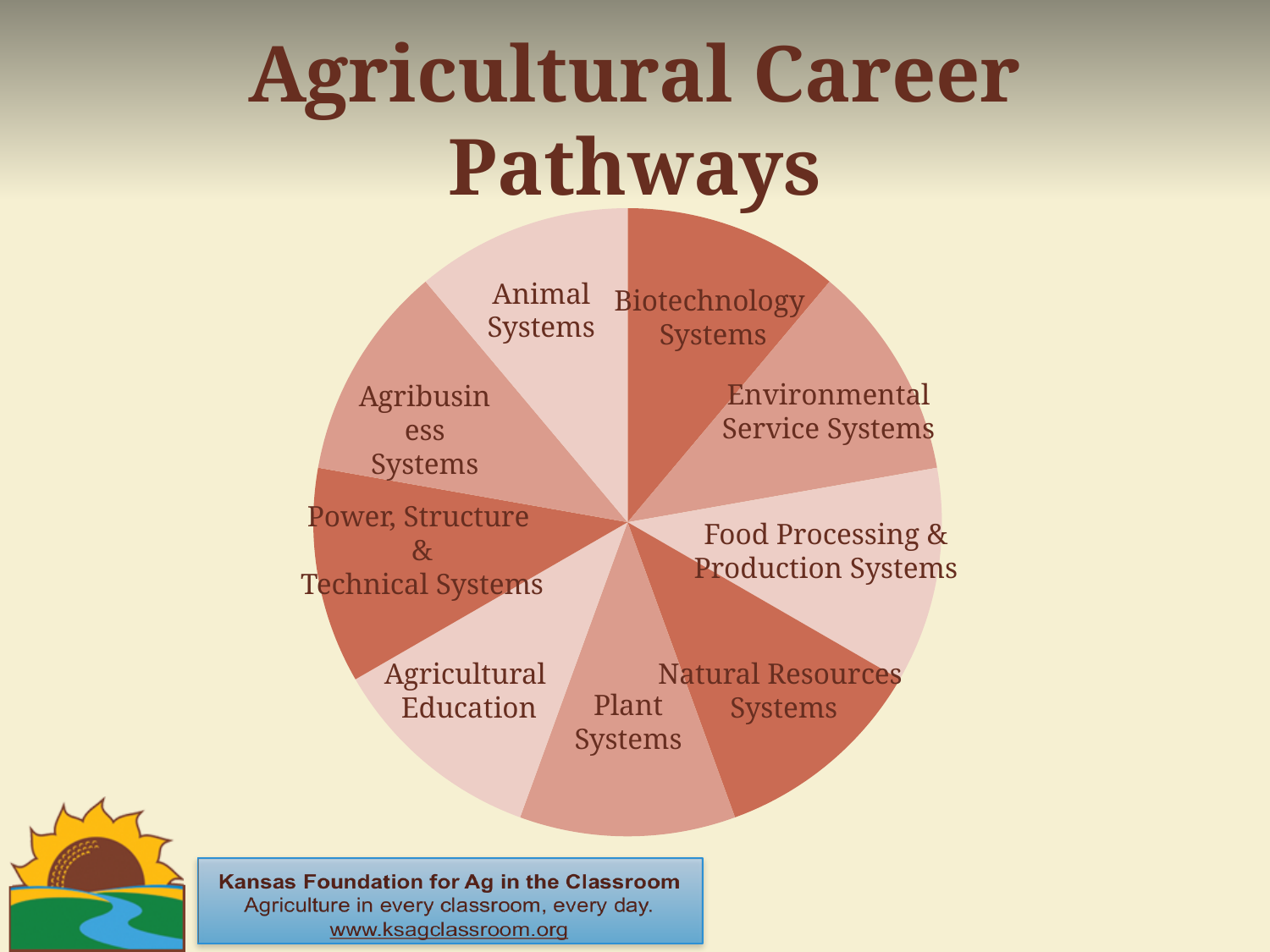
Do the slices of the pie chart appear to be equal in size or clearly different in size? Equal What kind of chart is shown on the slide? Pie chart How many slices does the pie chart have? 9 Which slice of the pie chart sits between Biotechnology Systems and Food Processing & Production Systems? Environmental Service Systems What is the title of the slide containing the pie chart? Agricultural Career Pathways